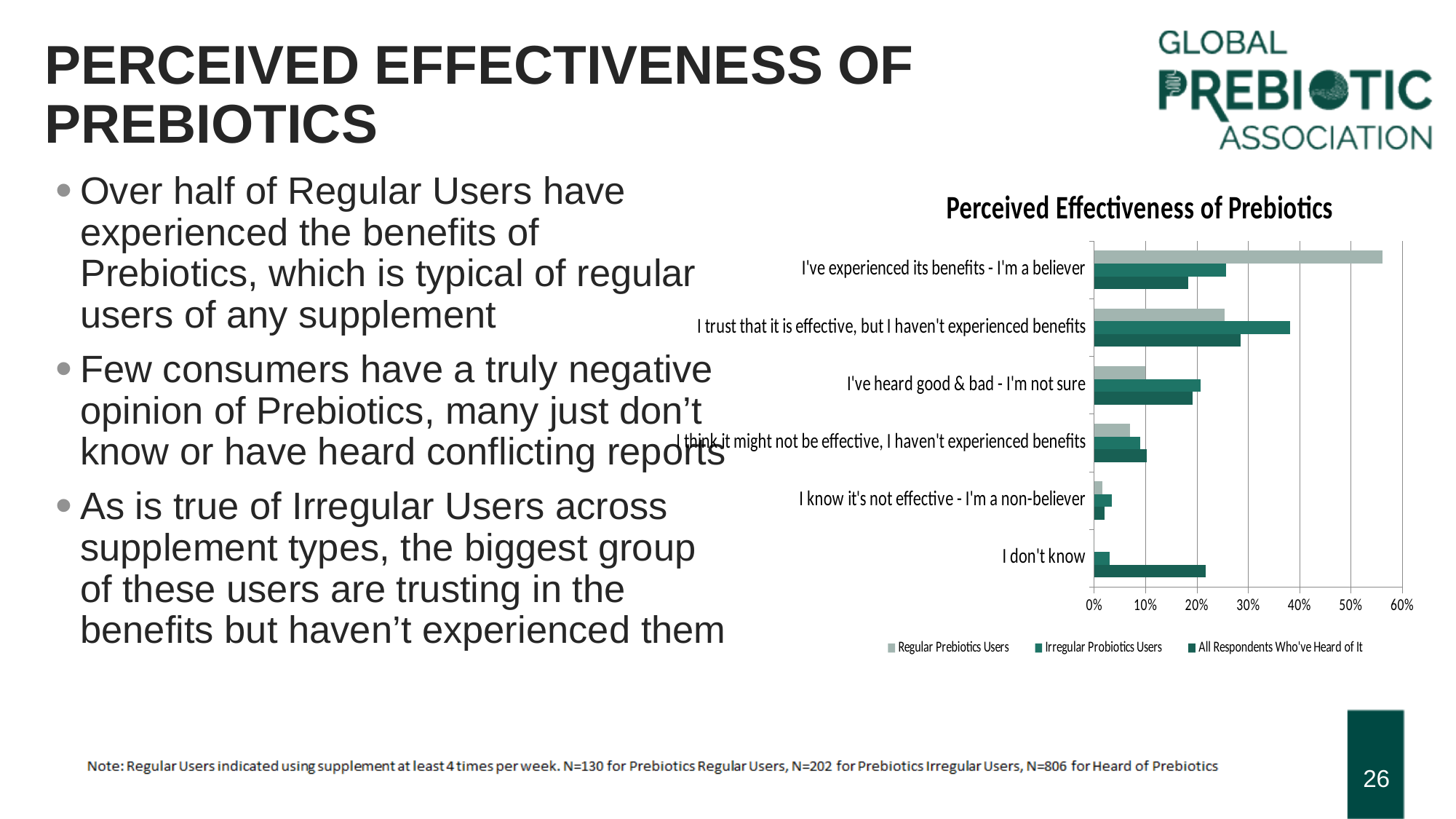
Which response category has the lowest value for Regular Prebiotics Users? I don't know Is the value for Irregular Probiotics Users on "I trust that it is effective, but I haven't experienced benefits" greater or less than 30%? greater Which response category has the highest value for Irregular Probiotics Users? I trust that it is effective, but I haven't experienced benefits Which response category has the highest value for Regular Prebiotics Users? I've experienced its benefits - I'm a believer Is the value for All Respondents Who've Heard of It on "I don't know" greater or less than 10%? greater What is the title of the chart? Perceived Effectiveness of Prebiotics For "I don't know", which series has the larger value: Irregular Probiotics Users or All Respondents Who've Heard of It? All Respondents Who've Heard of It How many response categories are plotted on the chart? 6 For "I've experienced its benefits - I'm a believer", which series has the larger value: Regular Prebiotics Users or Irregular Probiotics Users? Regular Prebiotics Users Is the value for Regular Prebiotics Users on "I've experienced its benefits - I'm a believer" greater or less than 50%? greater What kind of chart is shown on the slide? Bar chart How many series does the legend of the chart list? 3